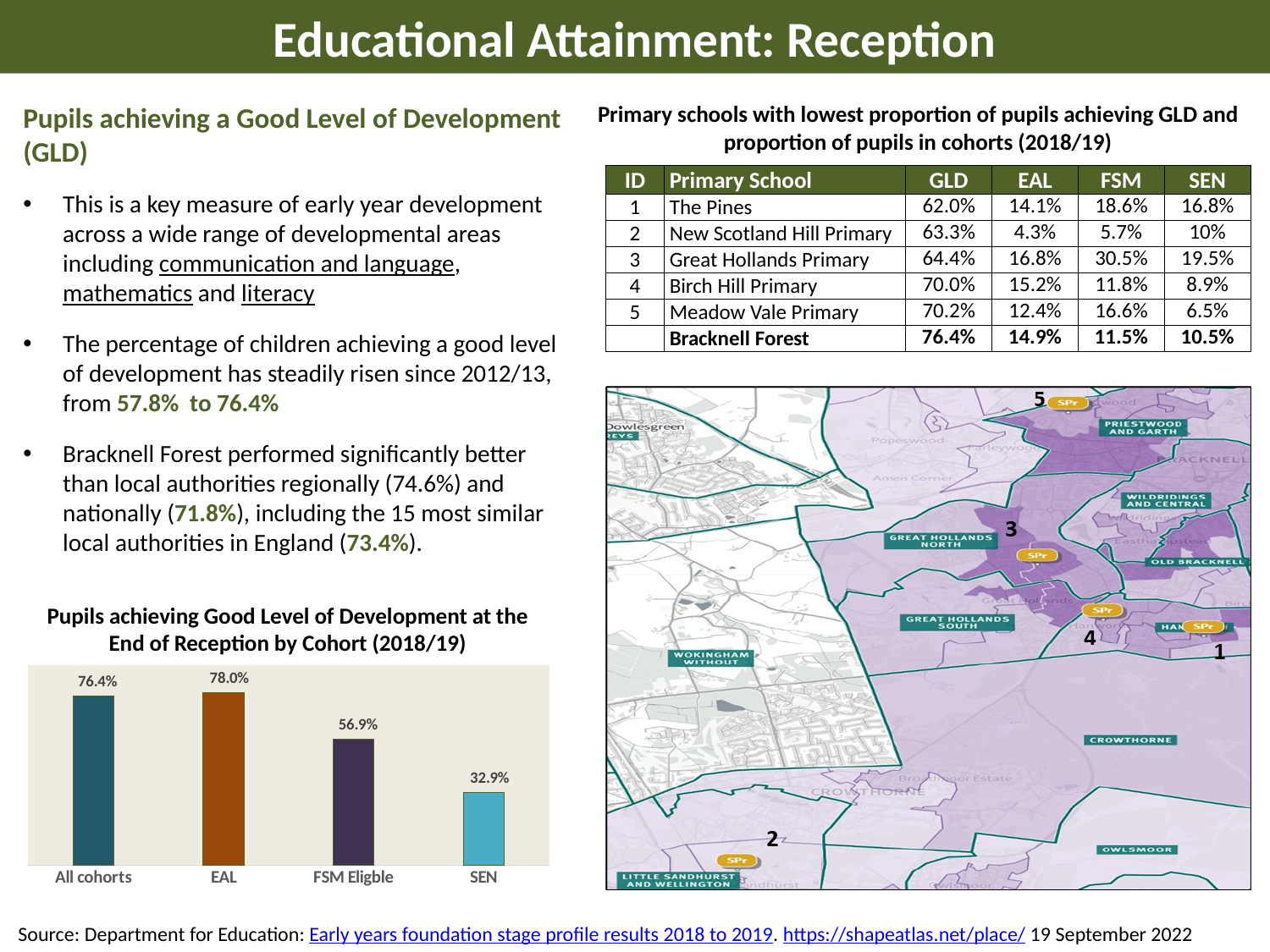
What percentage of pupils in the EAL cohort achieved a Good Level of Development according to the bar chart? 78.0% In the bar chart, what is the difference in percentage points between the EAL cohort and the SEN cohort? 45.1 What is the title of the bar chart on the slide? Pupils achieving Good Level of Development at the End of Reception by Cohort (2018/19) In the bar chart, which is larger: the value for FSM Eligble or the value for SEN? FSM Eligble What is the value shown for All cohorts in the bar chart? 76.4% How many cohorts are shown in the bar chart? 4 What is the value shown for the FSM Eligble cohort in the bar chart? 56.9% What type of chart is used to show Good Level of Development by cohort? Bar chart In the bar chart, what is the difference in percentage points between All cohorts and the FSM Eligble cohort? 19.5 What is the value shown for the SEN cohort in the bar chart? 32.9% Which cohort has the highest percentage achieving a Good Level of Development in the bar chart? EAL Which cohort has the lowest percentage achieving a Good Level of Development in the bar chart? SEN